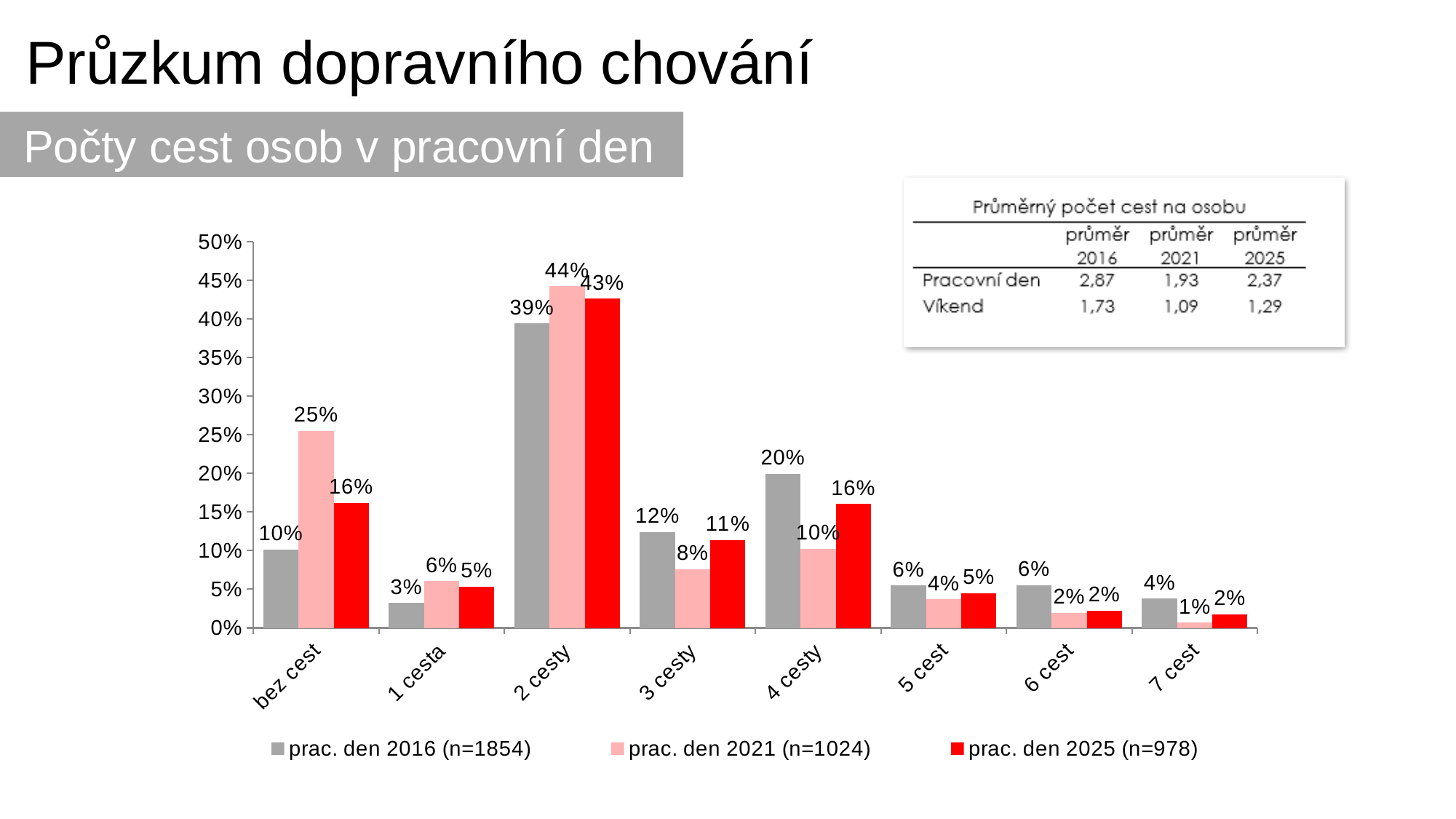
Which category has the lowest value in the 'prac. den 2016 (n=1854)' series? 1 cesta Which category has the highest value in the 'prac. den 2021 (n=1024)' series? 2 cesty What is the value for '4 cesty' in the 'prac. den 2016 (n=1854)' series? 20% How many categories are shown on the x axis of the chart? 8 Is the value for '2 cesty' in the 'prac. den 2016 (n=1854)' series greater or less than 35%? greater What colour represents the 'prac. den 2025 (n=978)' series in the chart? red What is the value for '2 cesty' in the 'prac. den 2025 (n=978)' series? 43% What is the difference between the 'prac. den 2021 (n=1024)' and 'prac. den 2016 (n=1854)' values for 'bez cest'? 15% What kind of chart is shown on the slide? bar chart Which is larger for '3 cesty': the 'prac. den 2016 (n=1854)' value or the 'prac. den 2025 (n=978)' value? prac. den 2016 (n=1854) What is the value for 'bez cest' in the 'prac. den 2021 (n=1024)' series? 25% How many series does the chart legend list? 3